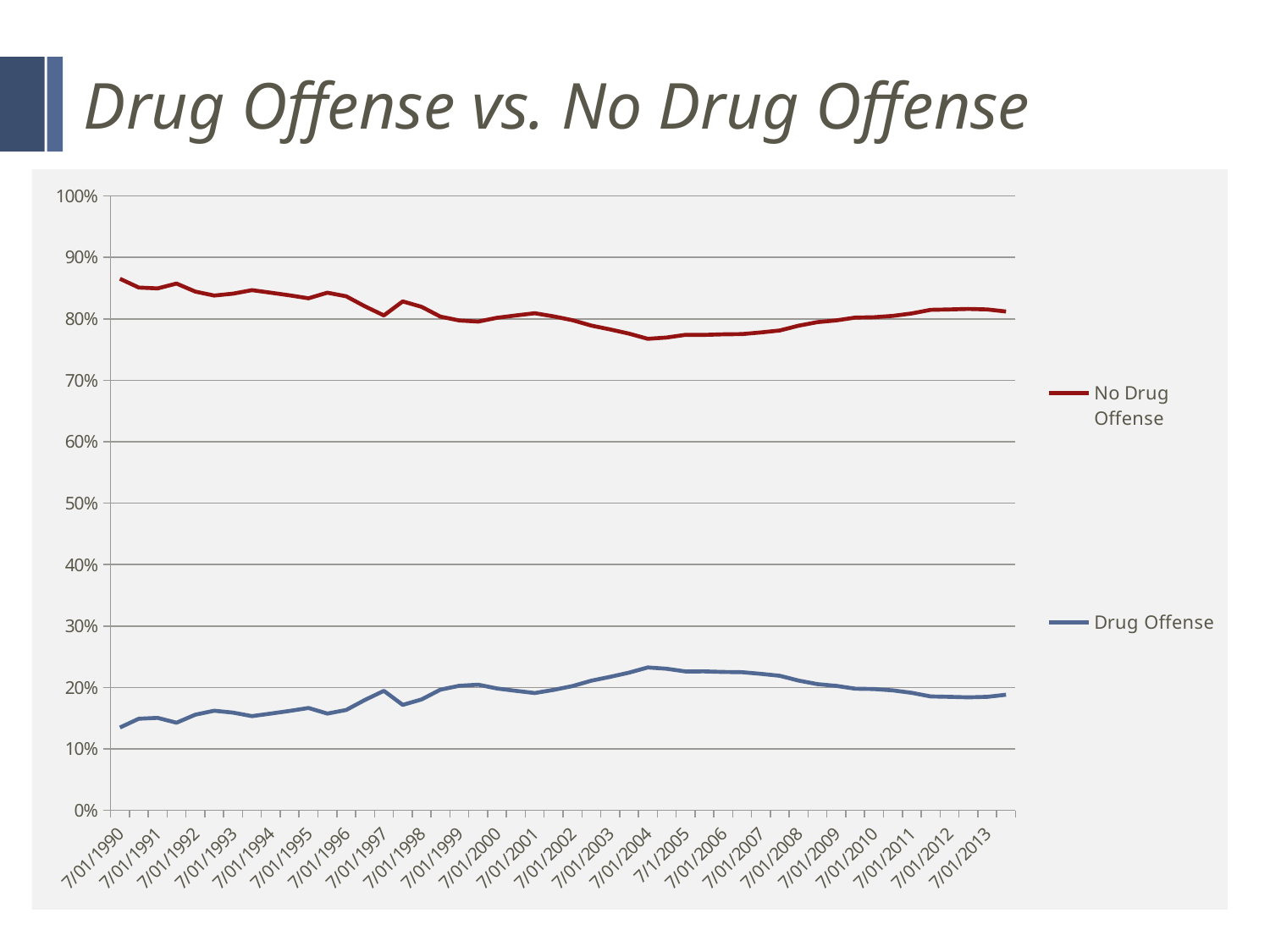
Does the No Drug Offense series rise or fall between 7/01/1990 and 7/01/2004? fall At 7/01/2004, which series has the higher value, No Drug Offense or Drug Offense? No Drug Offense Is the value for Drug Offense at 7/01/2013 greater or less than 20%? less What kind of chart is shown on the slide? line chart Is the value for No Drug Offense at 7/01/2004 greater or less than 80%? less What are the two series named in the legend? No Drug Offense and Drug Offense Does the Drug Offense series rise or fall between 7/01/1990 and 7/01/2004? rise What is the title of the slide containing the chart? Drug Offense vs. No Drug Offense Is the value for Drug Offense at 7/01/2004 greater or less than 20%? greater How many series does the legend list? 2